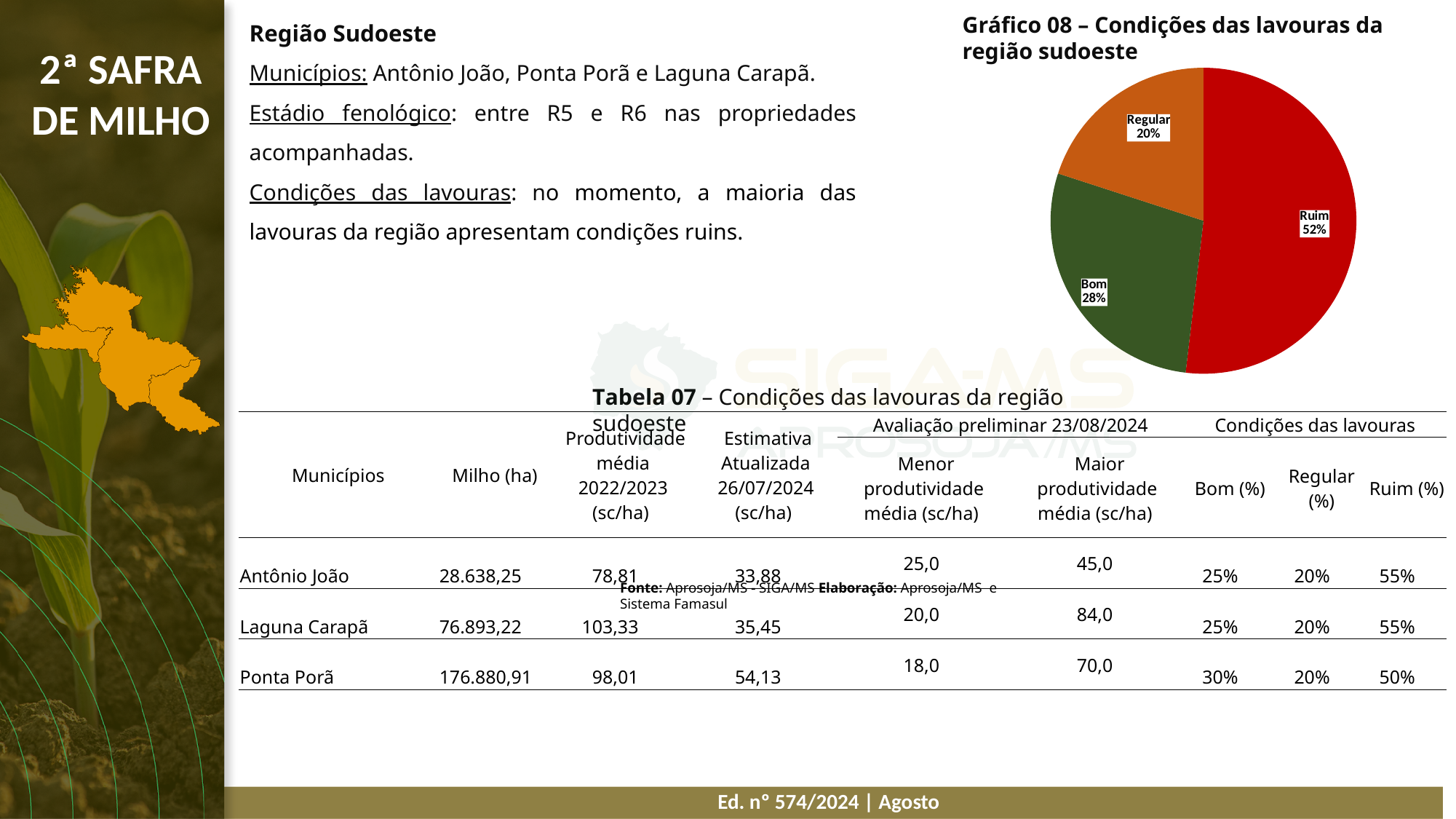
In Gráfico 08, what is the difference in percentage points between the Bom and Regular slices? 8 In Gráfico 08, which slice is larger, Bom or Regular? Bom What colour is the Ruim slice in Gráfico 08? red Which condition has the smallest slice in Gráfico 08? Regular What is the title of the pie chart on the slide? Gráfico 08 – Condições das lavouras da região sudoeste What kind of chart is Gráfico 08? pie chart In Gráfico 08, what share of the lavouras is in the Ruim condition? 52% In Gráfico 08, what share of the lavouras is in the Regular condition? 20% In Gráfico 08, what share of the lavouras is in the Bom condition? 28% Which condition has the largest slice in Gráfico 08? Ruim In Gráfico 08, what is the difference in percentage points between the Ruim and Bom slices? 24 How many slices does the pie in Gráfico 08 have? 3